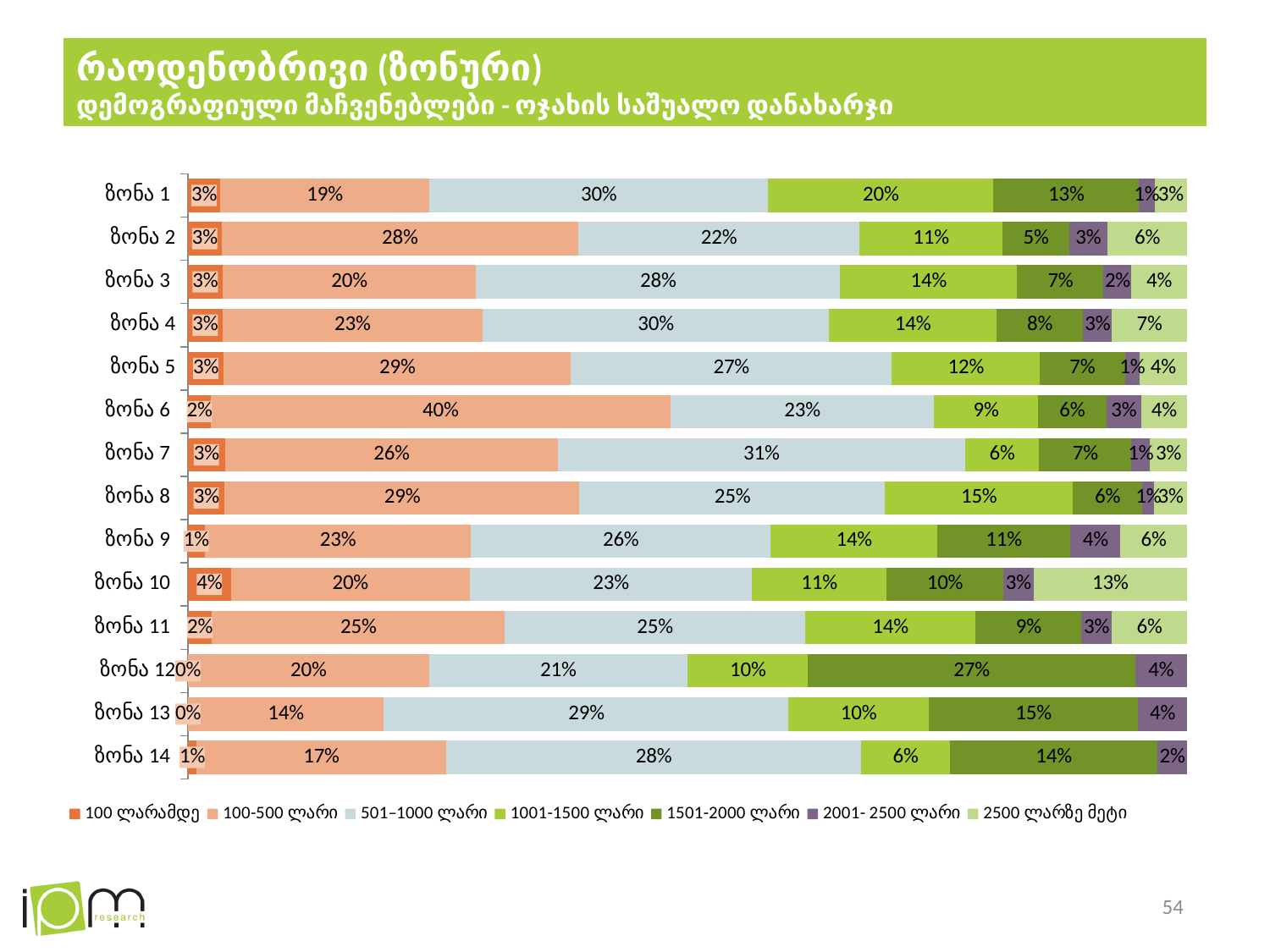
Which series is shown in the darkest green colour in the legend? 1501-2000 ლარი What is the value of the 100-500 ლარი segment for ზონა 6? 40% What is the value of the 501–1000 ლარი segment for ზონა 7? 31% How many zones (categories) are shown on the chart? 14 What is the difference between the 501–1000 ლარი values for ზონა 4 and ზონა 2? 8% What is the value of the 1501-2000 ლარი segment for ზონა 12? 27% Which zone has the highest value for the 1501-2000 ლარი series? ზონა 12 Which is larger: the 1001-1500 ლარი value for ზონა 1 or for ზონა 2? ზონა 1 How many series does the legend list? 7 What is the value of the 2500 ლარზე მეტი segment for ზონა 10? 13% Which zone has the highest value for the 100-500 ლარი series? ზონა 6 What kind of chart is shown on the slide? stacked bar chart